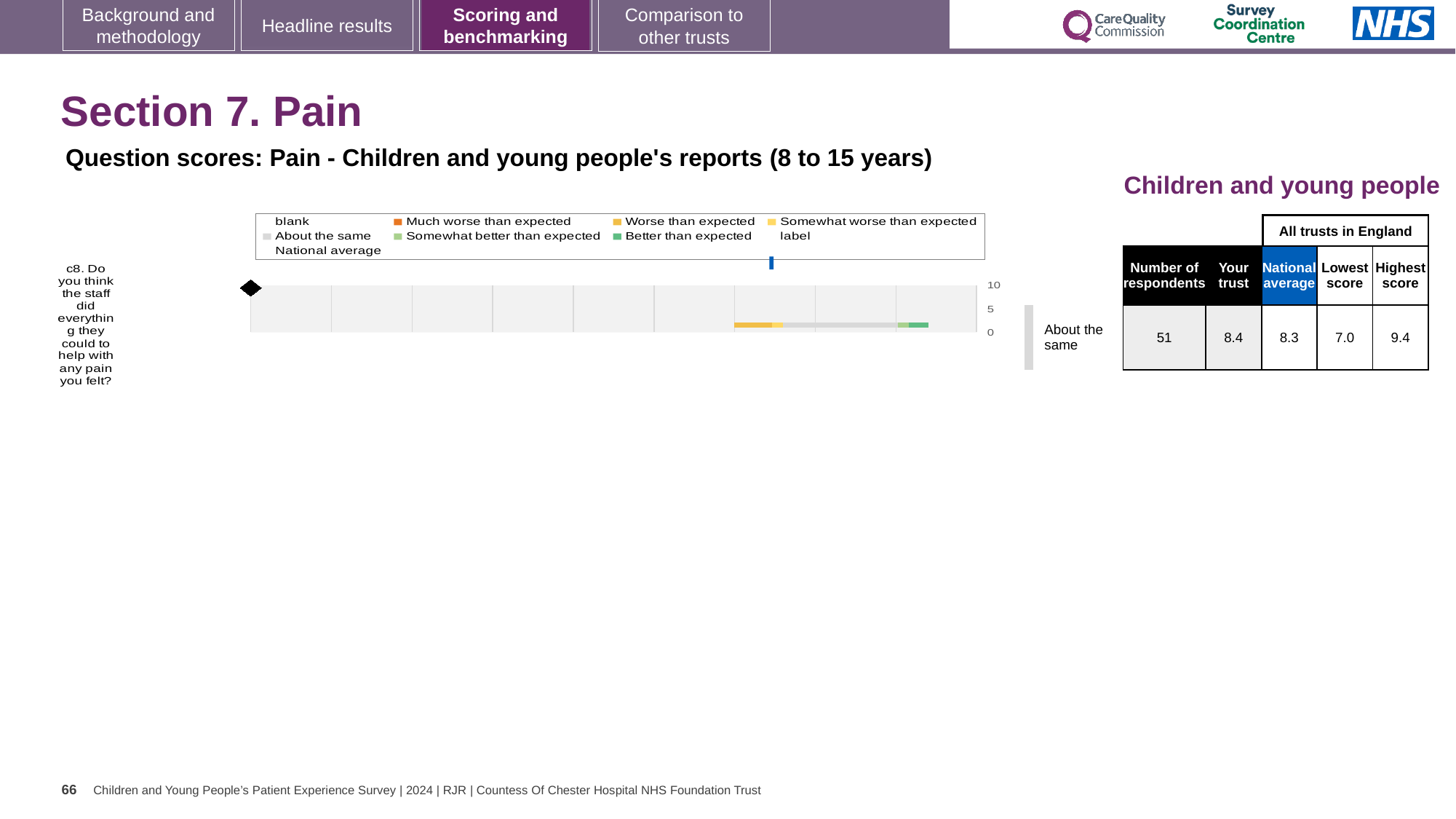
How many questions (categories) are plotted in the chart? 1 In the table beside the chart, what is the lowest score among all trusts in England for question c8? 7.0 What is the difference between the highest score and the lowest score for question c8? 2.4 Which legend entry is shown in dark green? Better than expected In the table beside the chart, what is the 'Your trust' score for question c8? 8.4 What kind of chart is shown on the slide? bar chart In the table beside the chart, what is the number of respondents for question c8? 51 What rating is shown next to the chart for question c8? About the same In the table beside the chart, what is the national average for question c8? 8.3 Which legend entry is shown in orange? Much worse than expected In the table beside the chart, what is the highest score among all trusts in England for question c8? 9.4 Which is larger for question c8, the 'Your trust' score or the national average? Your trust